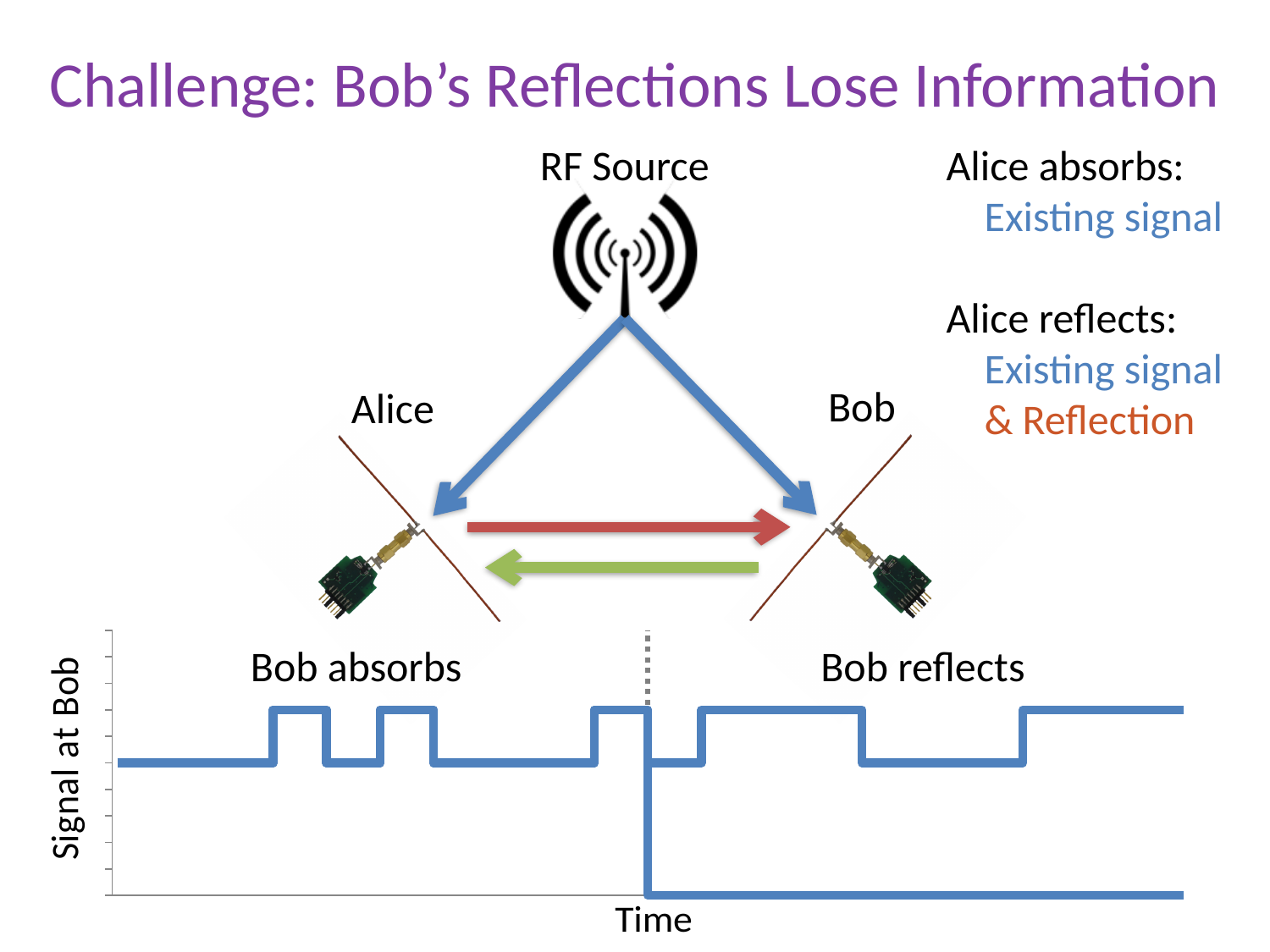
Is the lowest signal level in the 'Bob reflects' region higher or lower than the lowest level in the 'Bob absorbs' region? Lower What kind of chart is shown at the bottom of the slide? Line chart How many high pulses does the signal show in the 'Bob absorbs' region of the chart? 3 At the dotted vertical line separating the two regions, does the signal rise or fall? Fall What is the label on the vertical axis of the chart? Signal at Bob How many high pulses does the signal show in the 'Bob reflects' region of the chart? 2 What is the label on the horizontal axis of the chart? Time What are the two labelled regions of the chart, from left to right? Bob absorbs, Bob reflects